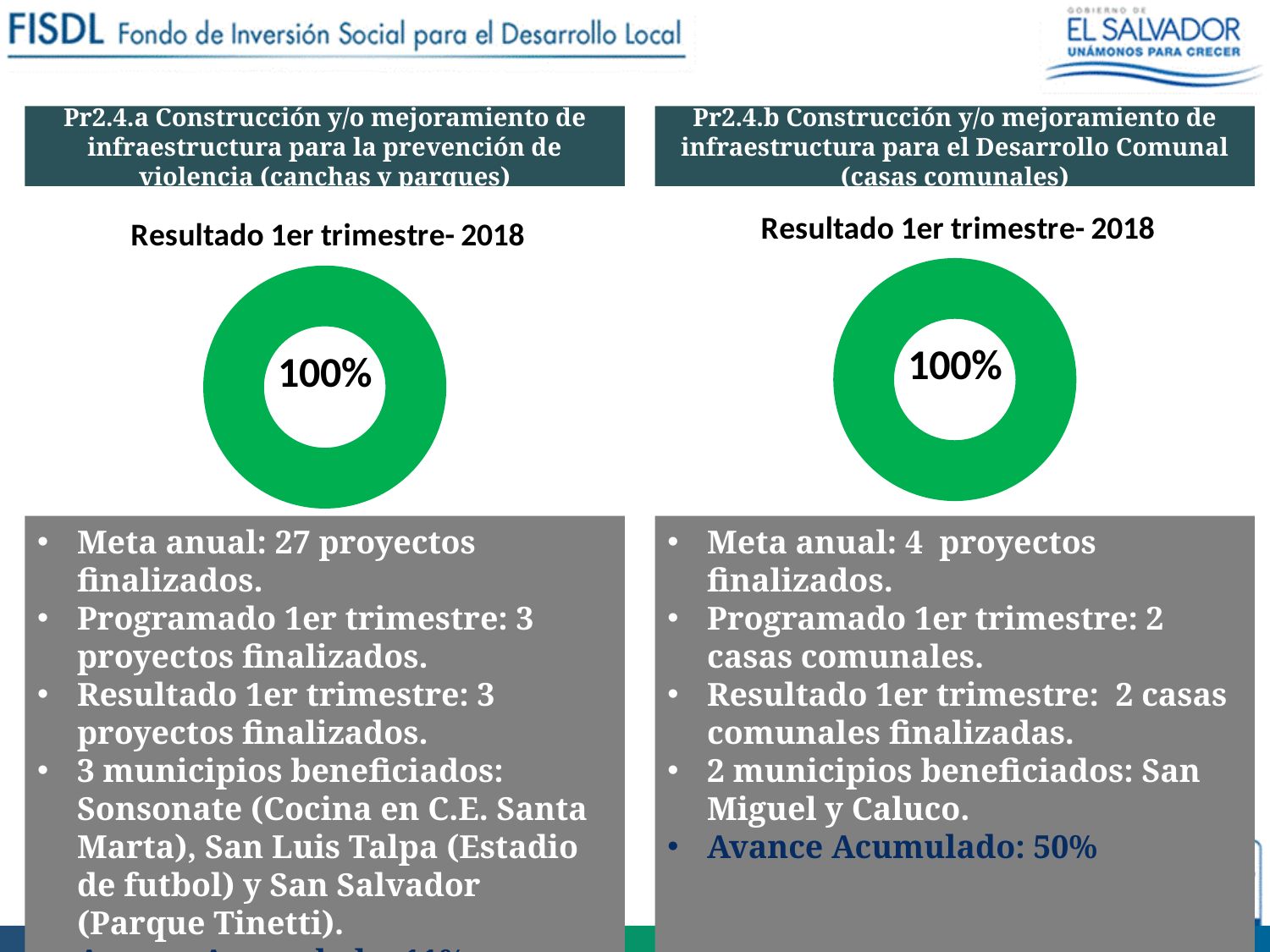
In the left chart (Pr2.4.a, canchas y parques), what percentage is printed in the centre of the doughnut? 100% In the right chart (Pr2.4.b, casas comunales), what percentage is printed in the centre of the doughnut? 100% What kind of chart is shown on the right side of the slide under 'Pr2.4.b'? Doughnut chart What colour is the filled ring of the right chart (Pr2.4.b)? Green In the left chart (Pr2.4.a), is the value shown greater or less than 50%? greater What kind of chart is shown on the left side of the slide under 'Pr2.4.a'? Doughnut chart What is the title printed above the left chart (Pr2.4.a)? Resultado 1er trimestre- 2018 Do the left chart (Pr2.4.a) and the right chart (Pr2.4.b) show the same percentage value? Yes, both show 100% How many doughnut charts are shown on the slide? 2 In the right chart (Pr2.4.b), is the value shown greater or less than 50%? greater